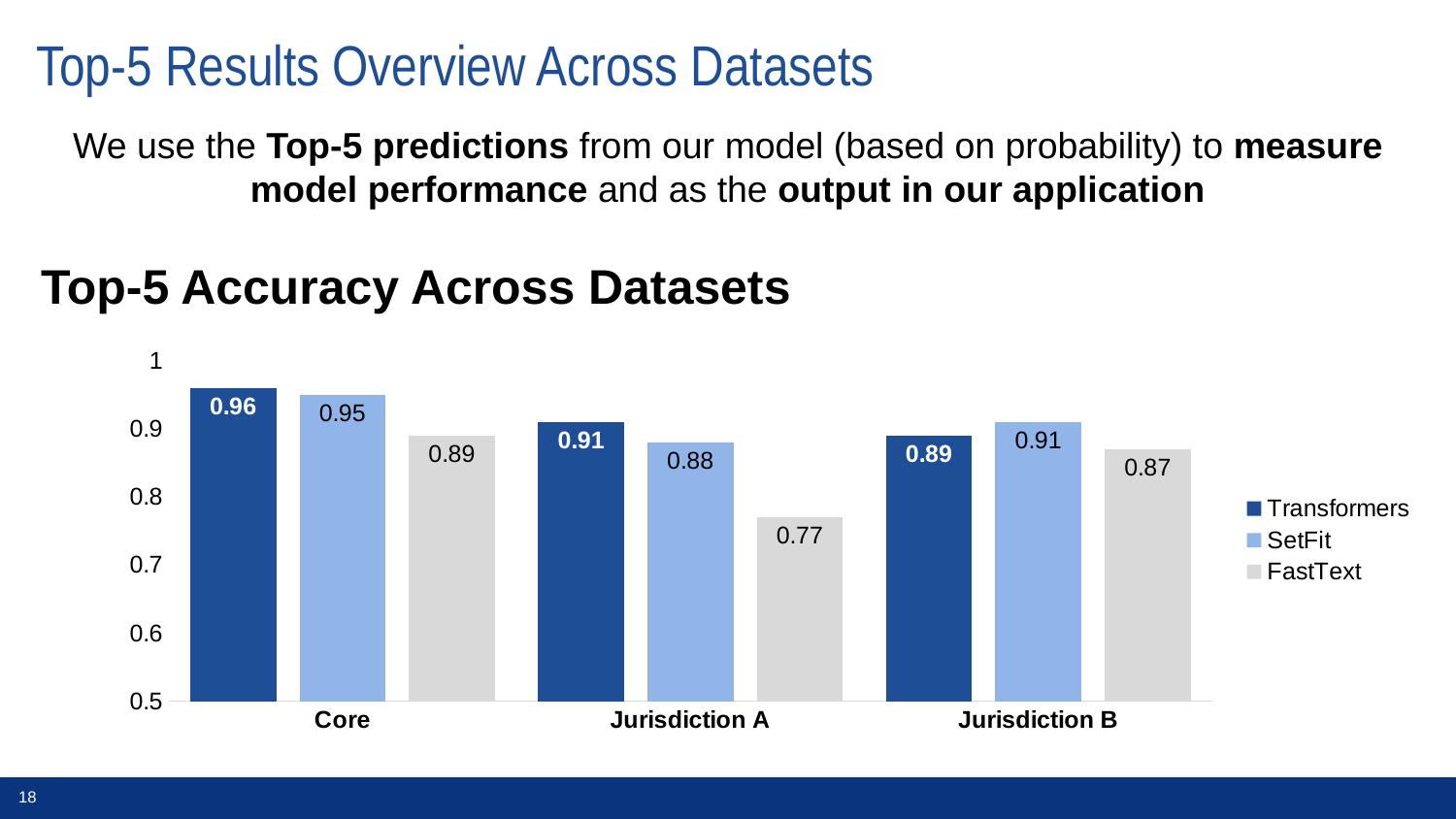
What is the title of the chart? Top-5 Accuracy Across Datasets Which dataset has the lowest FastText Top-5 accuracy? Jurisdiction A How many datasets are shown on the x axis of the chart? 3 Is the FastText Top-5 accuracy on Jurisdiction A greater or less than 0.8? less What is the difference between the Transformers and FastText Top-5 accuracy on Jurisdiction A? 0.14 Which model has the highest Top-5 accuracy on Jurisdiction B? SetFit What is the Top-5 accuracy of Transformers on the Core dataset? 0.96 What is the Top-5 accuracy of FastText on Jurisdiction A? 0.77 Which is larger on the Core dataset: the Transformers accuracy or the SetFit accuracy? Transformers How many series does the legend list? 3 What is the Top-5 accuracy of SetFit on Jurisdiction B? 0.91 What kind of chart is shown on the slide? Bar chart